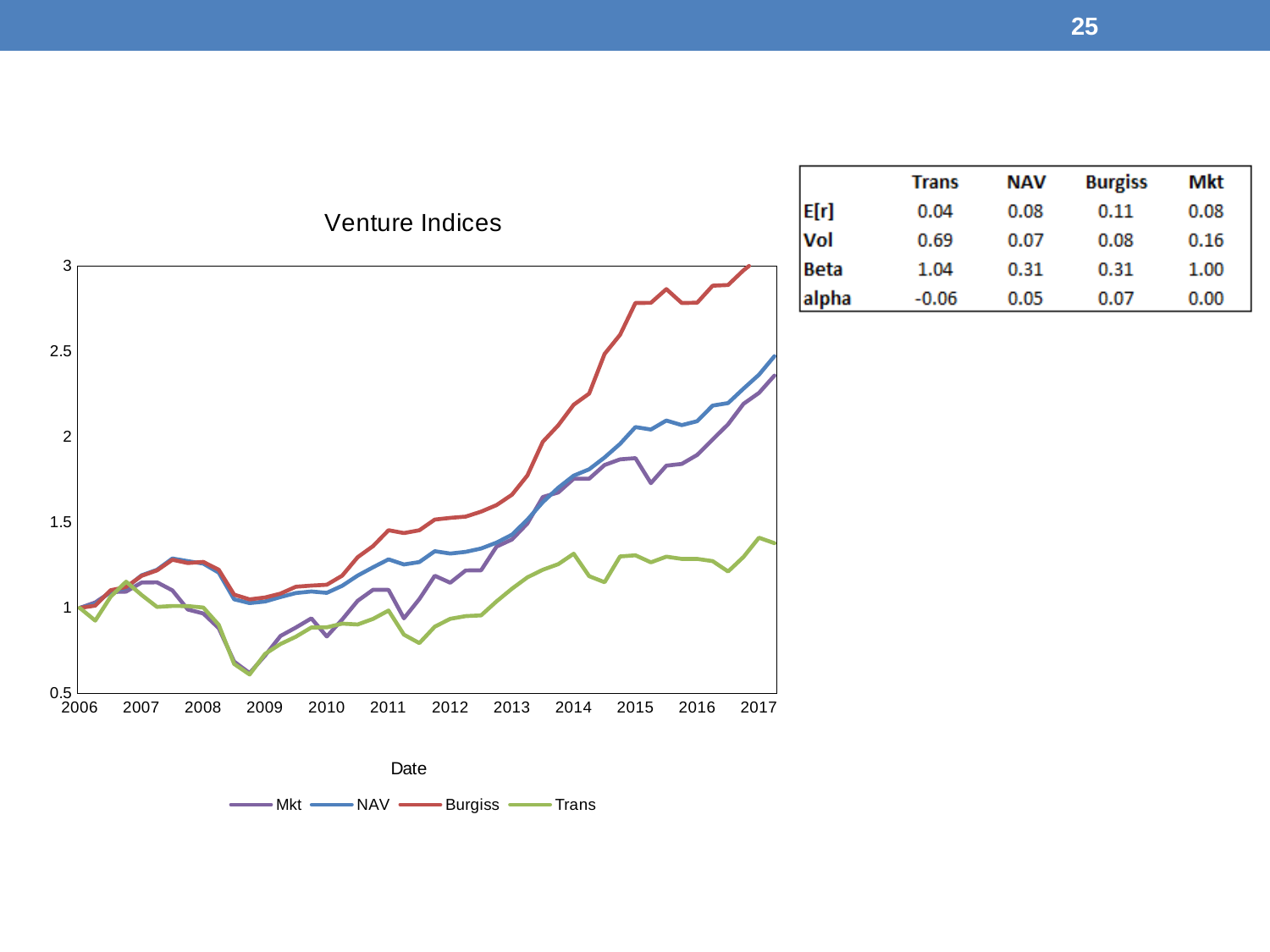
Is the value of Trans in 2017 greater or less than 1.5? less How many years are labeled on the x axis of the chart? 12 How many series does the legend of the Venture Indices chart list? 4 What is the label of the x axis of the chart? Date What kind of chart is shown on the slide? line chart Which series has the highest value at the end of the chart in 2017? Burgiss Does the Burgiss series rise or fall from 2009 to 2017? rise Which is larger in 2015, the value of NAV or the value of Mkt? NAV Is the value of Burgiss in 2017 greater or less than 2.5? greater Is the value of Trans in 2009 greater or less than 1? less Which series has the lowest value at the end of the chart in 2017? Trans What is the title of the chart? Venture Indices